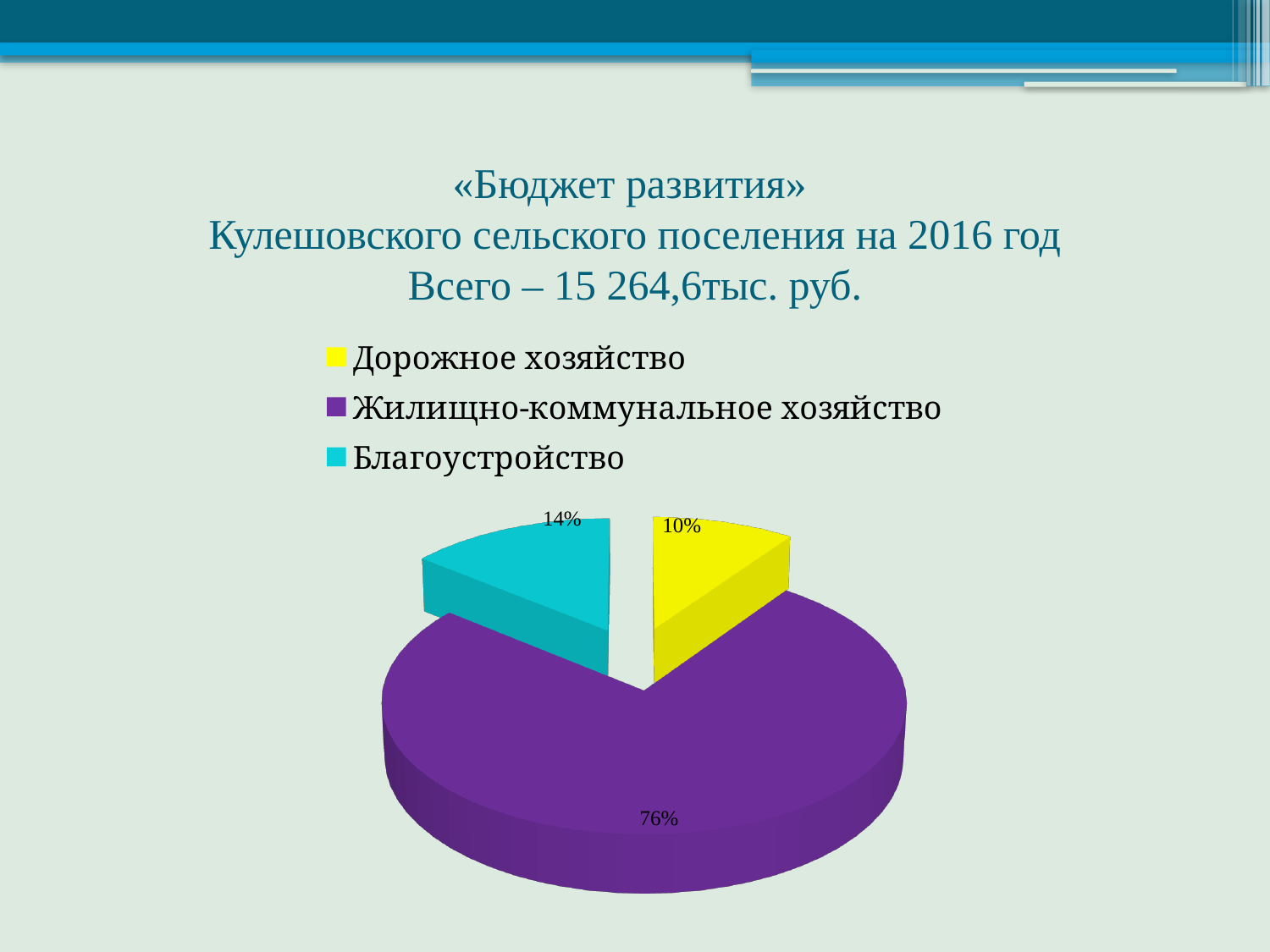
What colour is the slice for Благоустройство? cyan Which category has the largest share of the pie? Жилищно-коммунальное хозяйство What share of the pie does Дорожное хозяйство have? 10% How many categories does the pie chart have? 3 Which is larger, the share for Благоустройство or the share for Дорожное хозяйство? Благоустройство What kind of chart is shown on the slide? pie chart What total amount is stated in the chart title? 15 264,6тыс. руб. What is the difference in percentage points between Жилищно-коммунальное хозяйство and Благоустройство? 62 What share of the pie does Благоустройство have? 14% What is the difference in percentage points between Благоустройство and Дорожное хозяйство? 4 Which category has the smallest share of the pie? Дорожное хозяйство What share of the pie does Жилищно-коммунальное хозяйство have? 76%